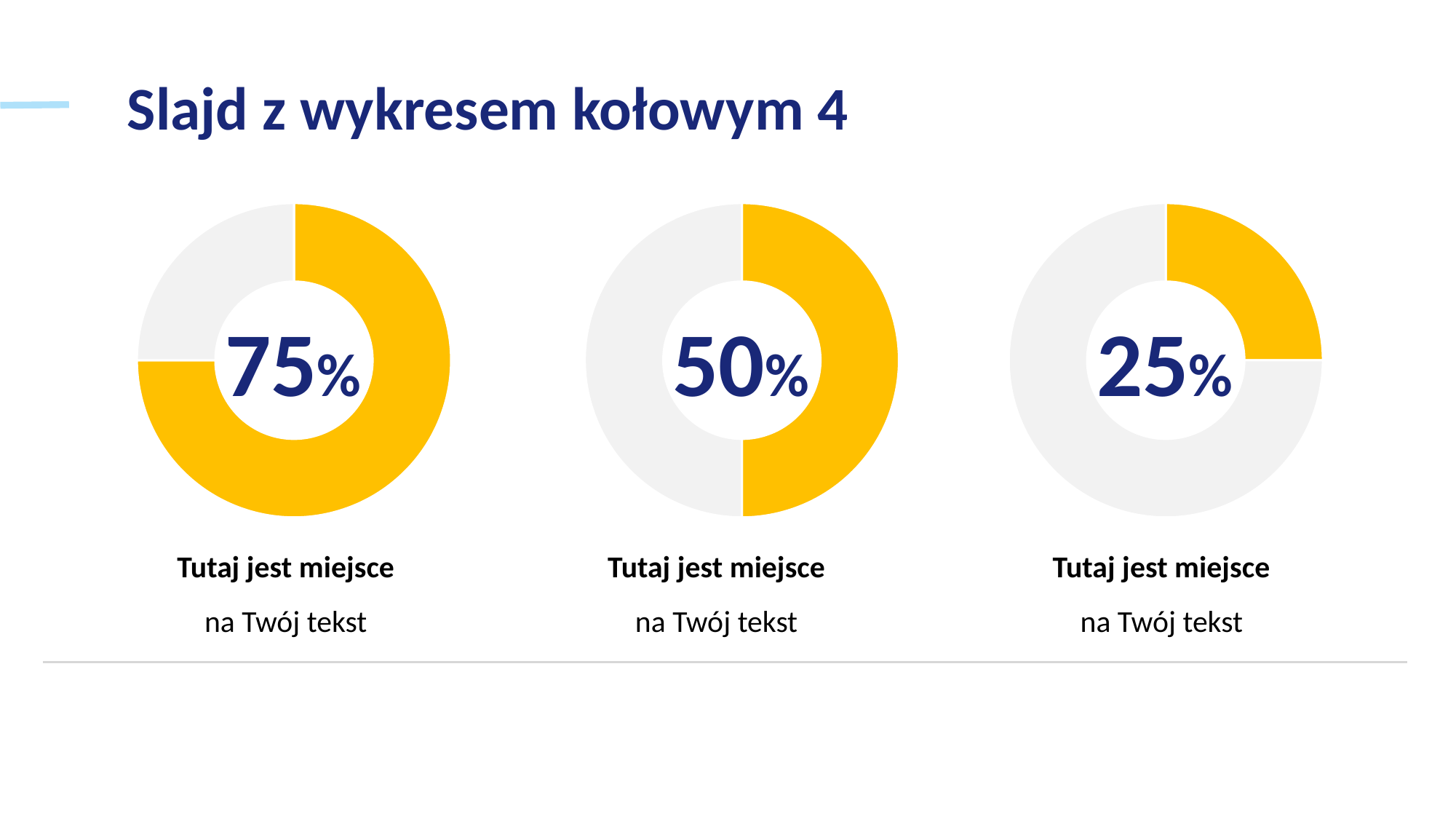
What type of chart is used on this slide? Donut (pie) chart What is the title of the slide? Slajd z wykresem kołowym 4 What is the difference between the percentage in the left donut chart and the percentage in the middle donut chart? 25% How many donut charts are shown on the slide? 3 What percentage is shown in the centre of the left donut chart? 75% What is the difference between the percentage in the left donut chart and the percentage in the right donut chart? 50% Which of the three donut charts shows the lowest percentage? The right chart (25%) What percentage is shown in the centre of the middle donut chart? 50% What colour is the filled (highlighted) portion of each donut chart? Yellow Which of the three donut charts shows the highest percentage? The left chart (75%) Is the percentage in the middle donut chart larger or smaller than the percentage in the right donut chart? Larger What percentage is shown in the centre of the right donut chart? 25%